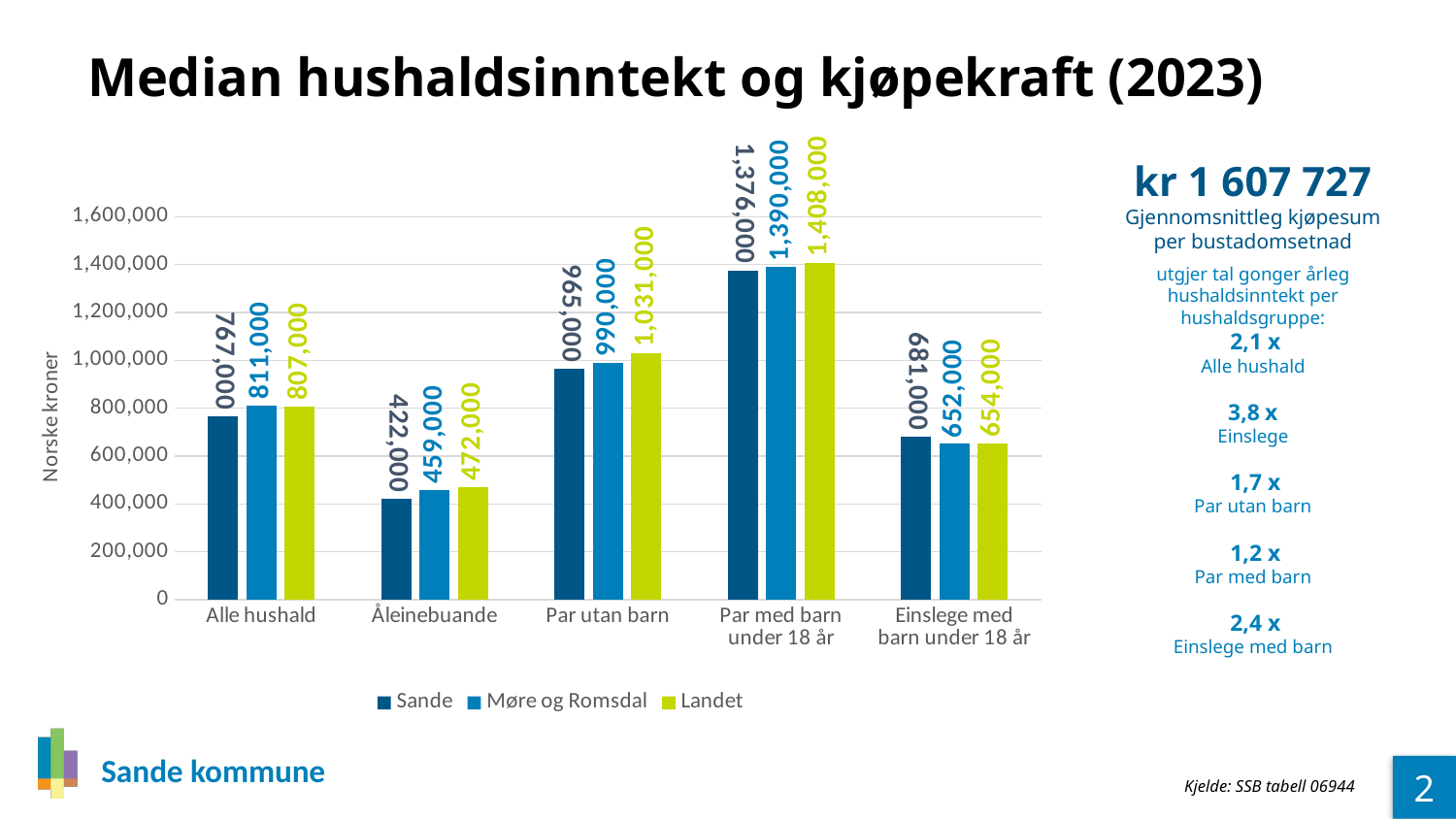
What is the value for Sande in the Einslege med barn under 18 år category? 681,000 What is the label of the y axis? Norske kroner How many series does the legend list? 3 What is the value for Landet in the Par utan barn category? 1,031,000 How many categories are shown on the x axis? 5 What kind of chart is shown on the slide? Bar chart What is the value for Møre og Romsdal in the Åleinebuande category? 459,000 Which category has the highest value for Landet? Par med barn under 18 år In the Åleinebuande category, which is larger: the value for Sande or the value for Landet? Landet What is the value for Sande in the Alle hushald category? 767,000 Which category has the lowest value for Sande? Åleinebuande What is the difference between the Landet and Sande values in the Par med barn under 18 år category? 32,000